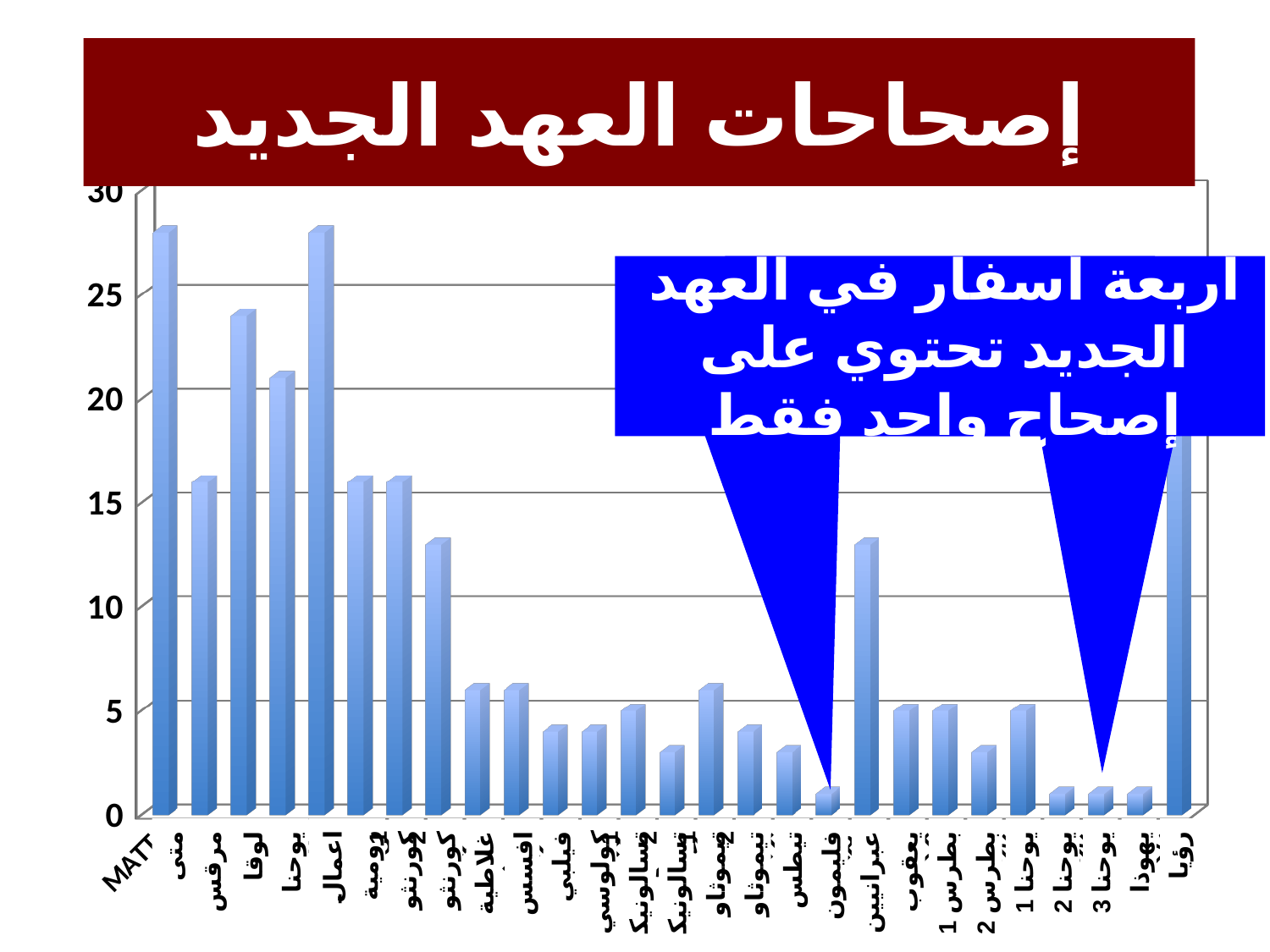
Is the value for متى greater or less than 25? greater What is the highest value shown on the vertical axis of the chart? 30 Which has the larger value, رؤيا or عبرانيين? رؤيا Is the value for عبرانيين greater or less than 10? greater What kind of chart is shown on the slide? bar chart Which has the larger value, عبرانيين or يعقوب? عبرانيين Which has the larger value, لوقا or مرقس? لوقا What is the title of the chart on the slide? إصحاحات العهد الجديد Is the value for فليمون greater or less than 5? less